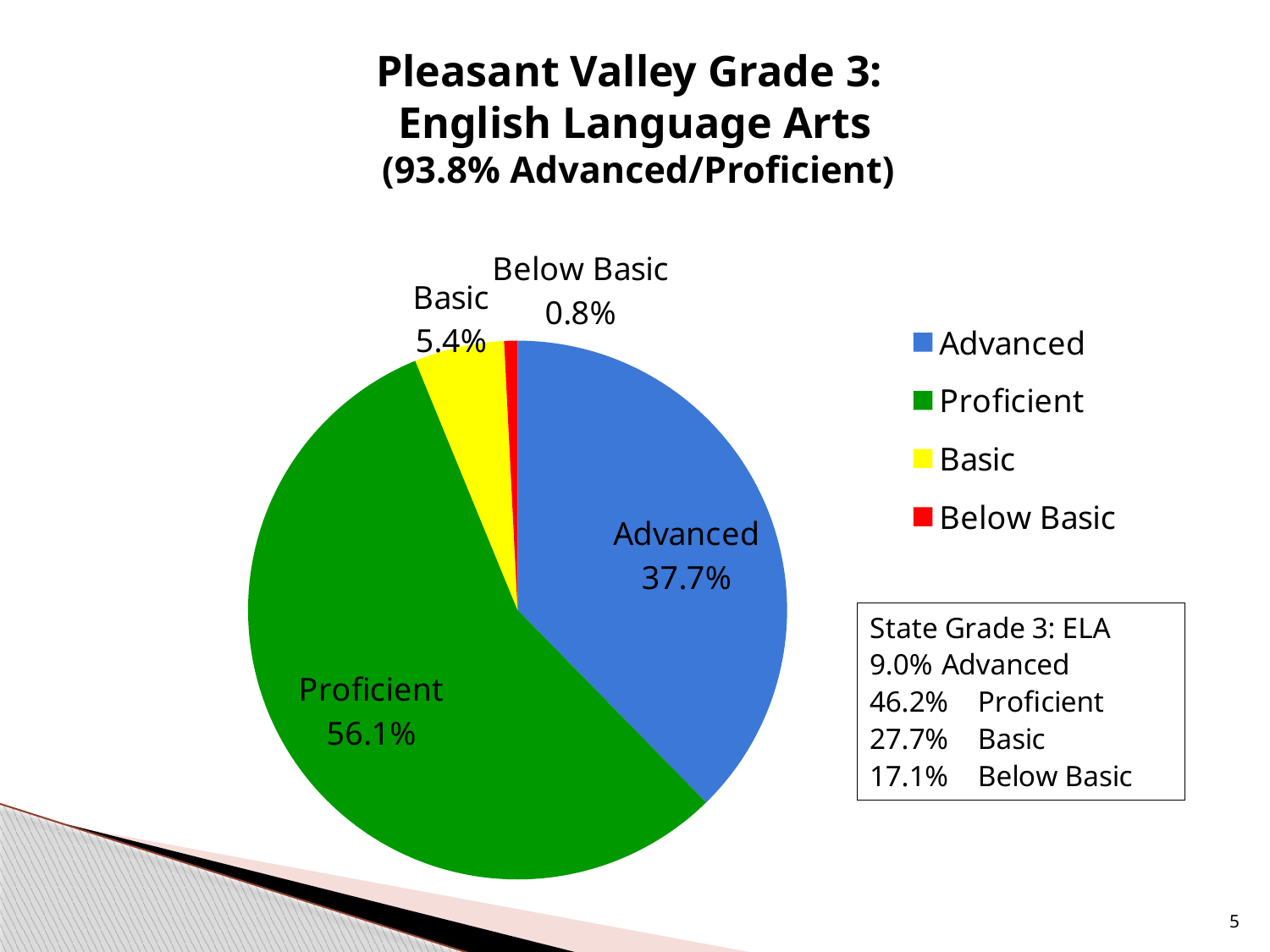
How many entries does the legend list? 4 What colour is the Proficient slice in the pie chart? green What percentage of students scored Advanced? 37.7% How many slices does the pie chart have? 4 What percentage of Pleasant Valley Grade 3 students scored Proficient in English Language Arts? 56.1% Which performance level has the largest share of the pie? Proficient What is the difference in percentage points between the Proficient and Advanced slices? 18.4 What percentage of students scored Below Basic? 0.8% What type of chart is shown on the slide? pie chart Which is larger, the Basic slice or the Below Basic slice? Basic Which performance level has the smallest share of the pie? Below Basic What percentage of students scored Basic? 5.4%